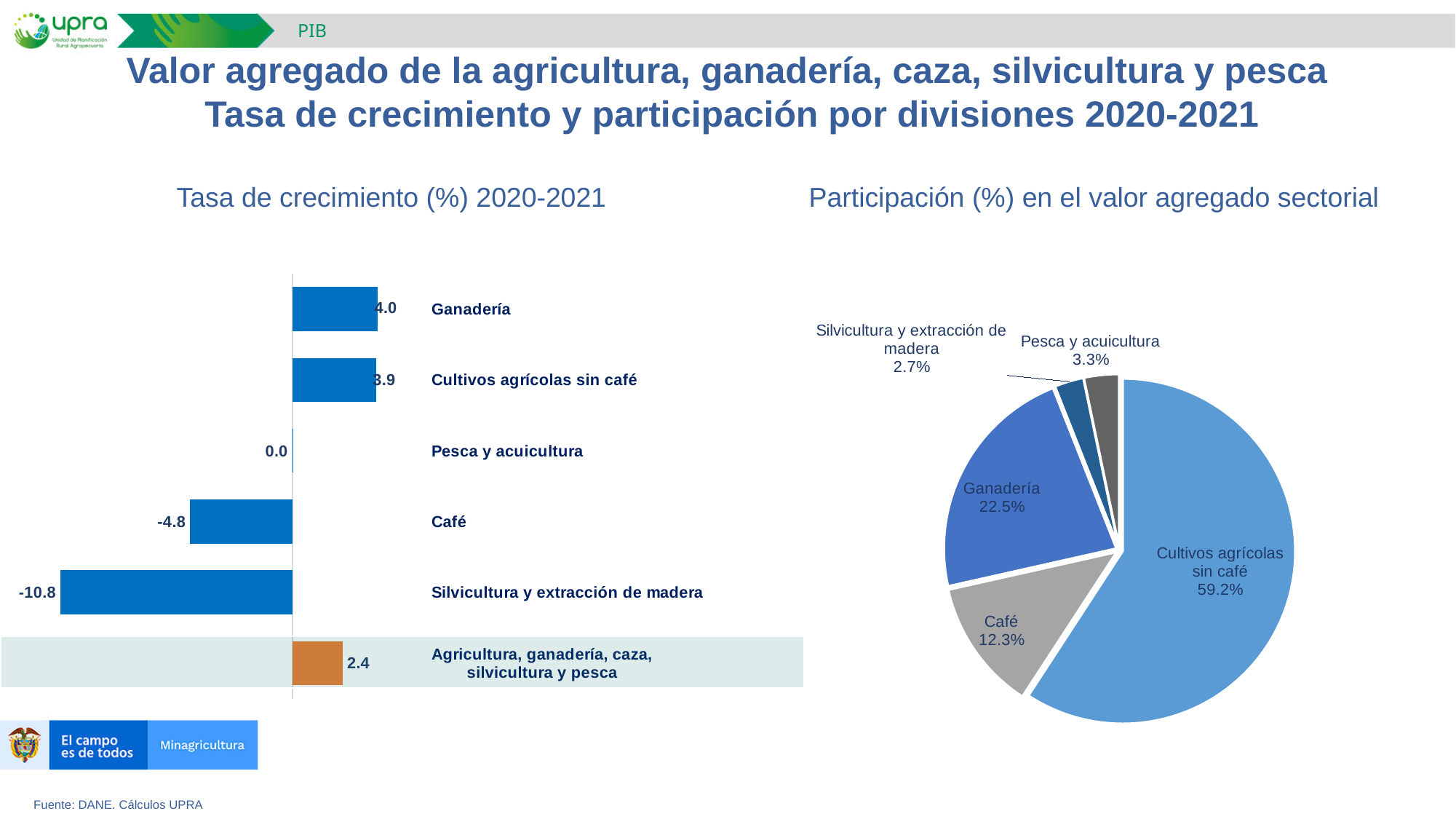
In the 'Participación (%) en el valor agregado sectorial' chart, which slice is the smallest? Silvicultura y extracción de madera In the 'Participación (%) en el valor agregado sectorial' chart, what is the value for Café? 12.3% In the 'Participación (%) en el valor agregado sectorial' chart, which is larger, Ganadería or Pesca y acuicultura? Ganadería In the 'Tasa de crecimiento (%) 2020-2021' chart, what is the value for Silvicultura y extracción de madera? -10.8 In the 'Tasa de crecimiento (%) 2020-2021' chart, what is the value for Ganadería? 4.0 In the 'Tasa de crecimiento (%) 2020-2021' chart, which category has the lowest value? Silvicultura y extracción de madera In the 'Tasa de crecimiento (%) 2020-2021' chart, what is the value for Agricultura, ganadería, caza, silvicultura y pesca? 2.4 In the 'Tasa de crecimiento (%) 2020-2021' chart, which category has the highest value? Ganadería What kind of chart is the 'Tasa de crecimiento (%) 2020-2021' chart? Bar chart In the 'Tasa de crecimiento (%) 2020-2021' chart, what is the difference between the values for Ganadería and Café? 8.8 In the 'Participación (%) en el valor agregado sectorial' chart, what share does Cultivos agrícolas sin café have? 59.2% In the 'Tasa de crecimiento (%) 2020-2021' chart, how many categories are shown? 6